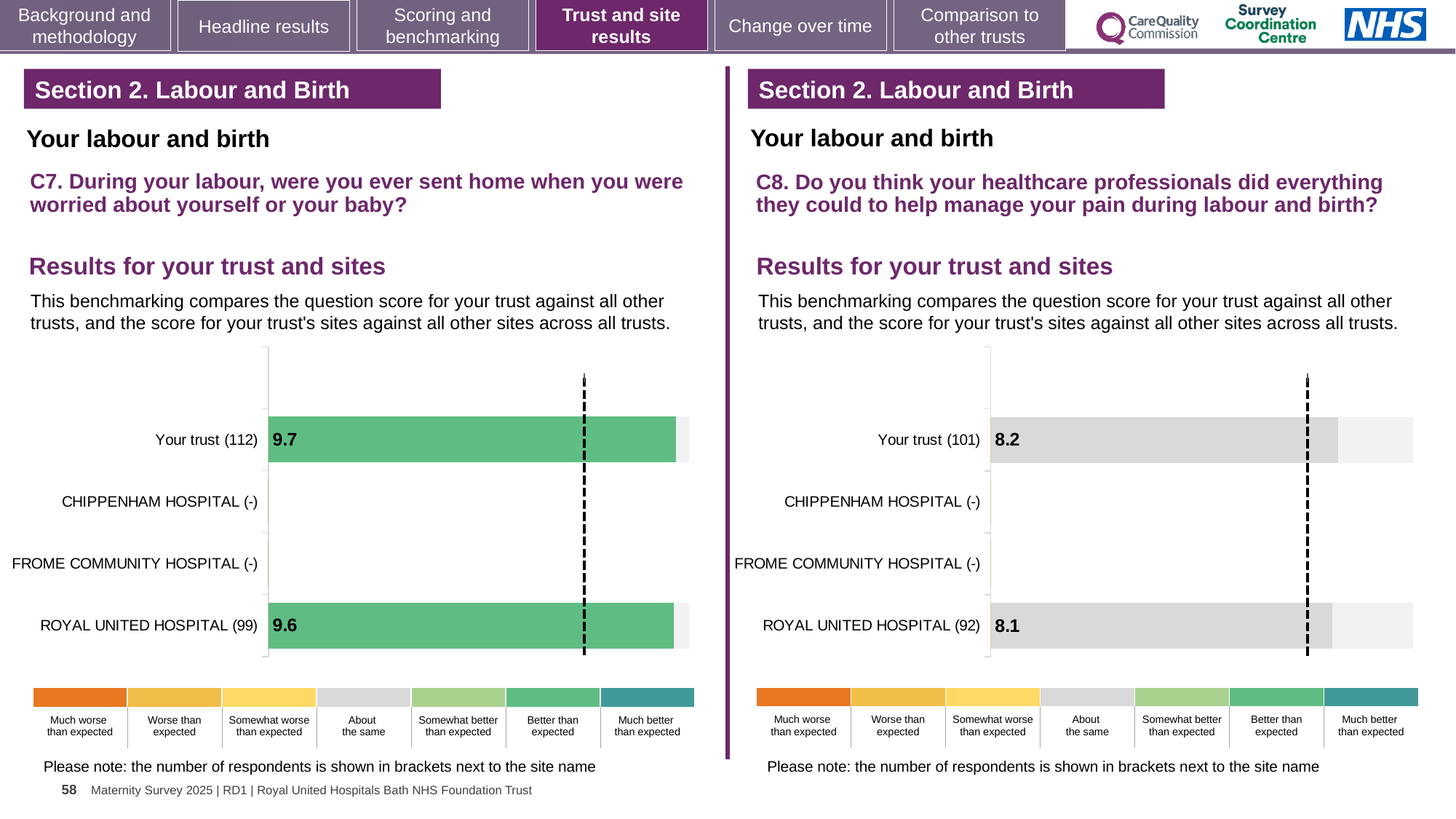
On the right chart (C8), which has the higher score, Your trust or Royal United Hospital? Your trust On the left chart (C7), what is the score for Your trust? 9.7 On the left chart (C7), what is the difference between the score for Your trust and the score for Royal United Hospital? 0.1 On the right chart (C8), how many respondents are shown in brackets for Your trust? 101 On the left chart (C7), what is the score for Royal United Hospital? 9.6 On the right chart (C8), what is the score for Your trust? 8.2 On the left chart (C7), which benchmark category does the green colour of the bars correspond to in the legend? Better than expected On the left chart (C7), how many respondents are shown in brackets for Royal United Hospital? 99 On the right chart (C8), what is the score for Royal United Hospital? 8.1 On the right chart (C8), which benchmark category does the grey colour of the bars correspond to in the legend? About the same What kind of chart is used on the right side of the slide (C8)? Bar chart How many site or trust categories are listed on the left chart (C7)? 4